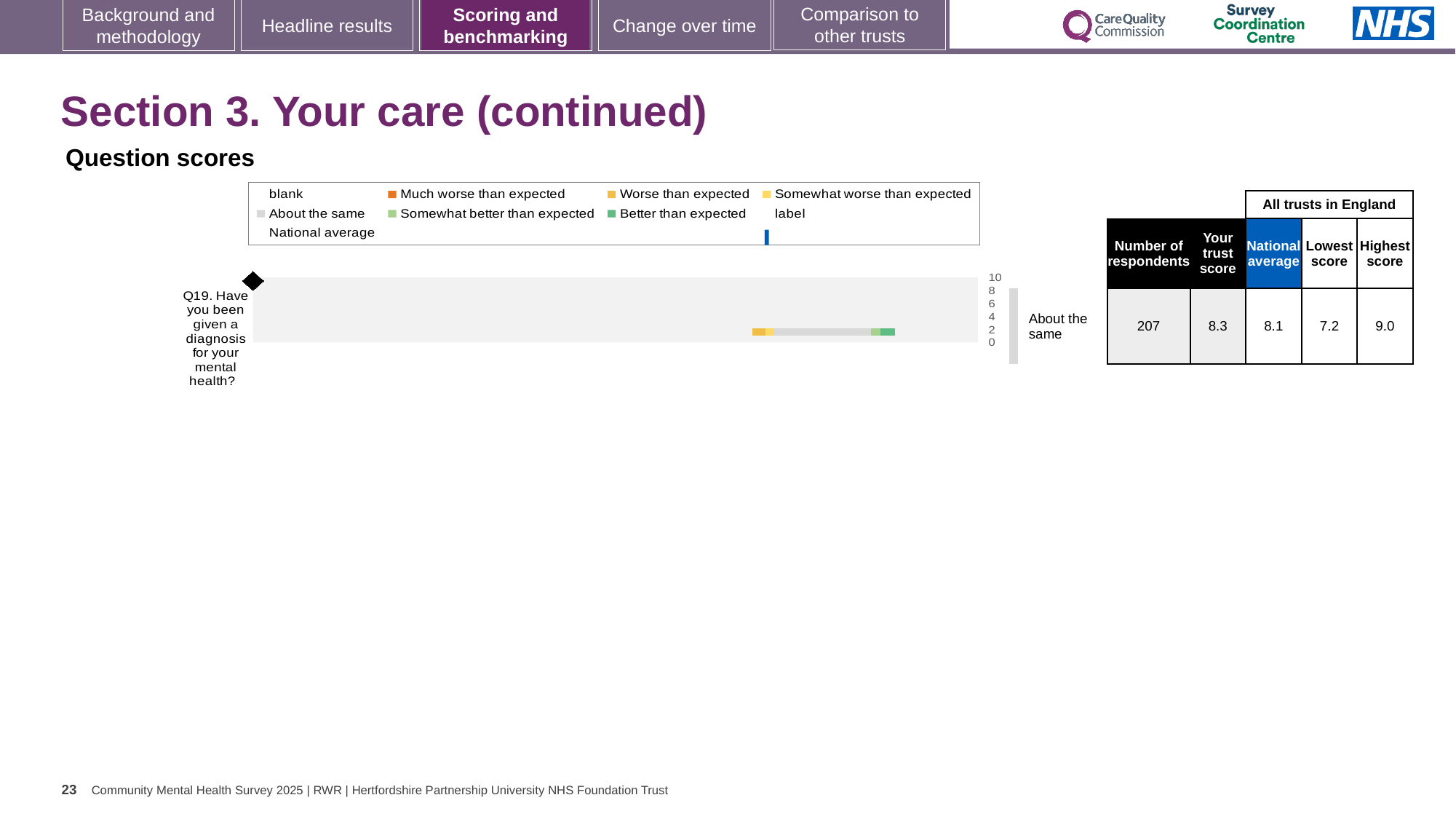
Is the trust score for Q19 greater or less than the national average? greater What is the benchmark category shown for Q19? About the same How many respondents answered Q19? 207 What is the difference between the highest and lowest scores for Q19? 1.8 What is the highest score among all trusts in England for Q19? 9.0 What is the national average score for Q19? 8.1 What is the trust score for Q19? 8.3 Is the trust score for Q19 greater or less than 8? greater How many survey questions are plotted in the chart? 1 What kind of chart is shown under 'Question scores'? bar chart Which question is plotted in the chart? Q19. Have you been given a diagnosis for your mental health? What is the lowest score among all trusts in England for Q19? 7.2